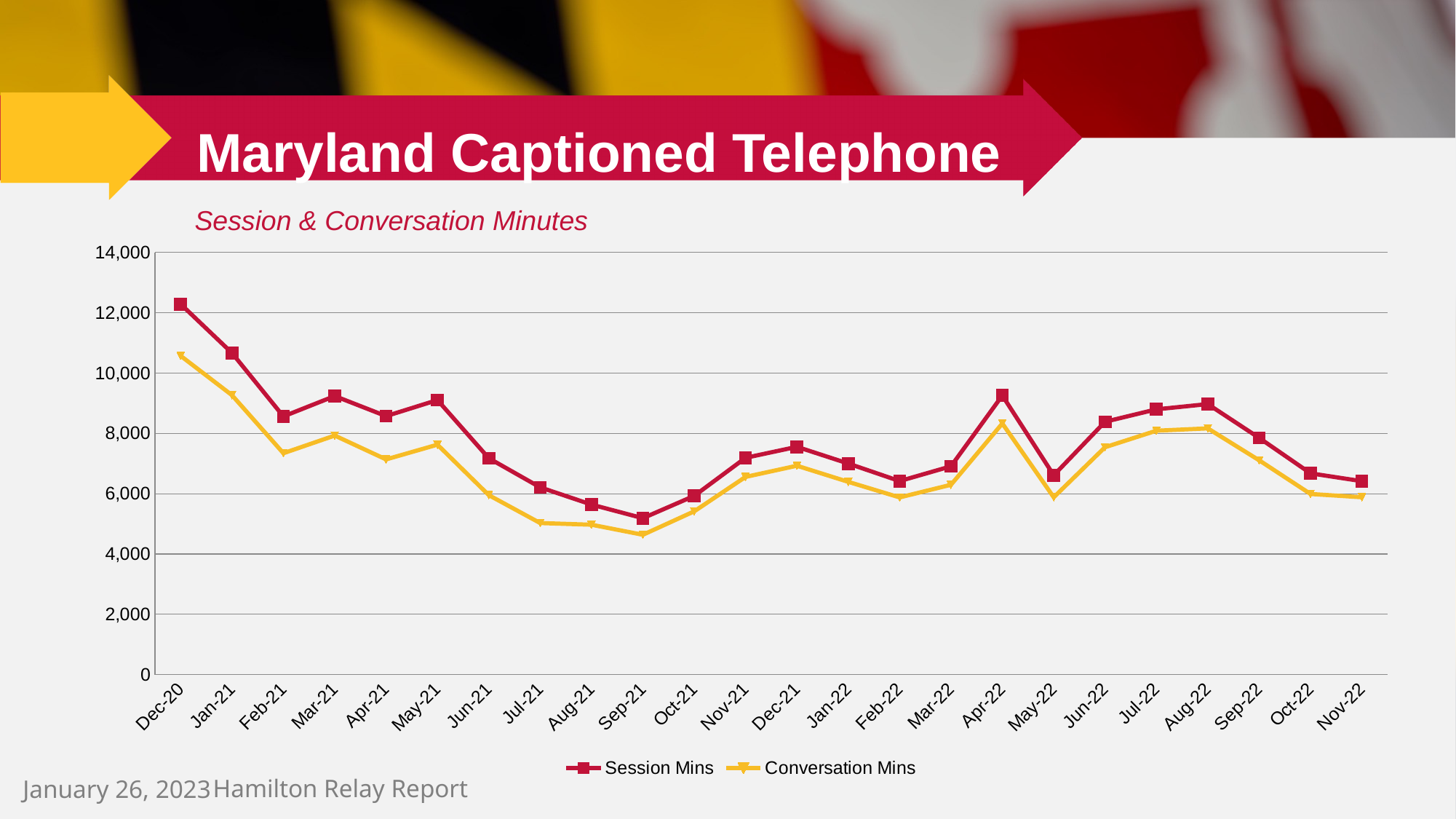
Is the value for Conversation Mins in Sep-21 greater or less than 6,000? less Which colour is used for the Conversation Mins line? yellow In which month is Session Mins highest? Dec-20 Is the value for Session Mins in Dec-20 greater or less than 12,000? greater In which month is Conversation Mins lowest? Sep-21 Is the value for Session Mins in Apr-22 greater or less than 8,000? greater How many months are plotted along the x axis? 24 What kind of chart is shown on the slide? line chart Do Session Mins rise or fall from Dec-20 to Feb-21? fall Which is larger, Session Mins in Apr-22 or Session Mins in May-22? Apr-22 How many series does the legend list? 2 In which month is Session Mins lowest? Sep-21